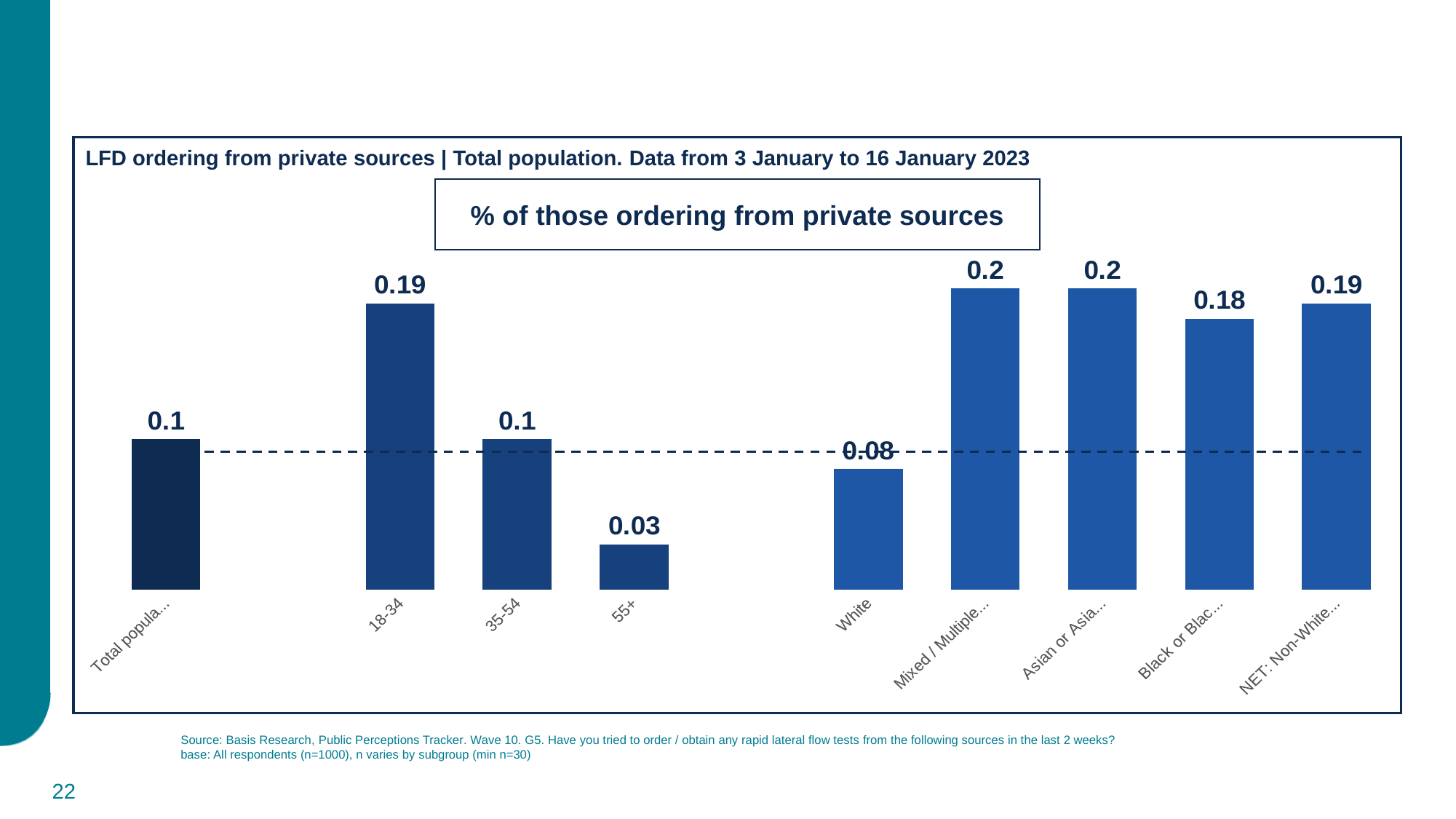
What is the value for the 18-34 age group? 0.19 What is the title shown in the box above the bars? % of those ordering from private sources What is the difference between the values for 18-34 and White? 0.11 What is the difference between the values for 18-34 and 55+? 0.16 Which category has the lowest value? 55+ How many bars are plotted in the chart? 9 What is the value for the 35-54 age group? 0.1 What kind of chart is shown on the slide? bar chart What is the value for the 55+ age group? 0.03 What is the value for the White group? 0.08 Which has the larger value, 18-34 or 35-54? 18-34 Which has the larger value, White or 55+? White